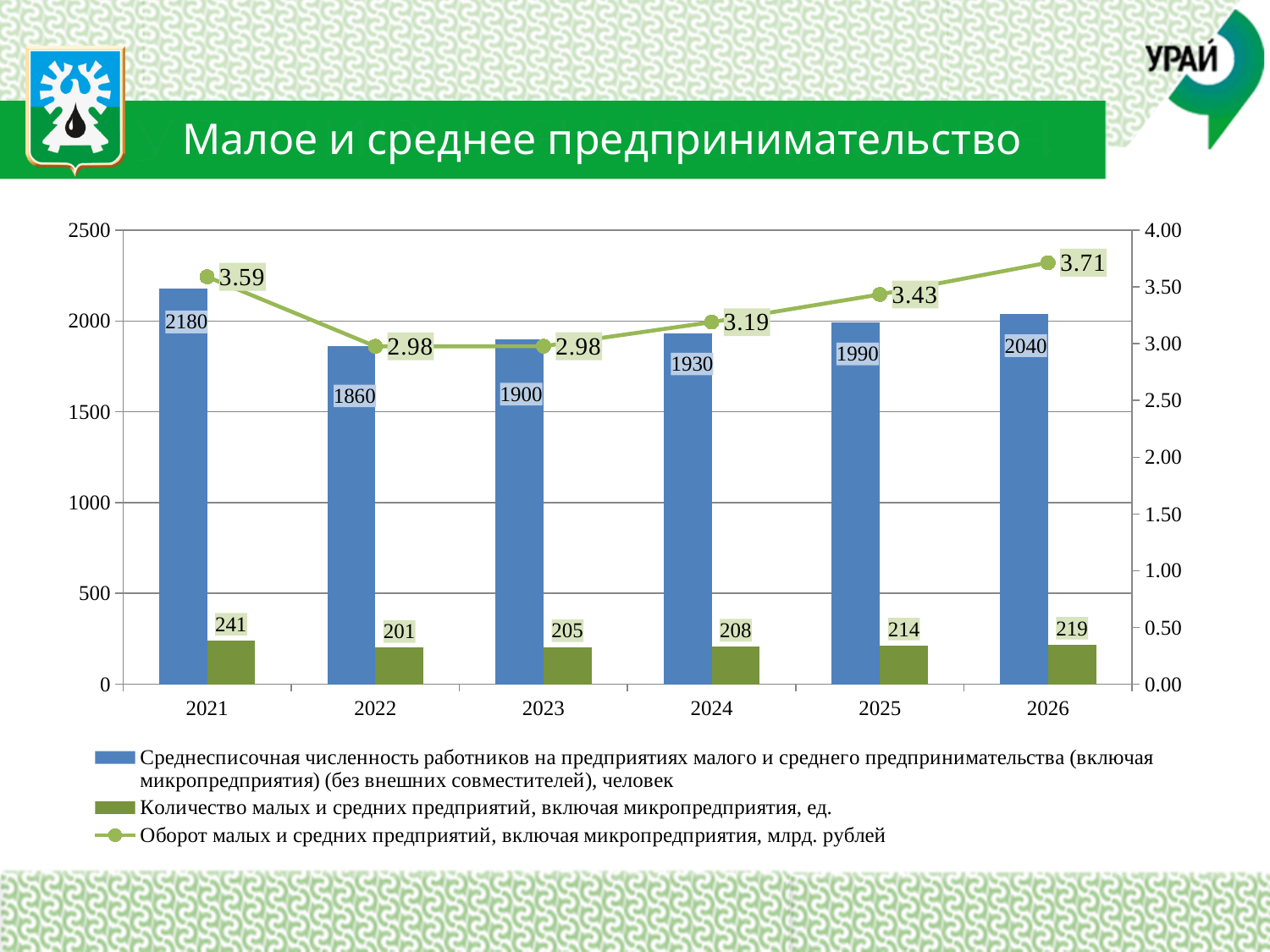
In which year is the number of small and medium enterprises (green bars) lowest? 2022 Which year has a larger number of small and medium enterprises (green bars): 2023 or 2026? 2026 In which year is the turnover of small and medium enterprises (line) highest? 2026 How many series does the legend of the chart list? 3 How many years are shown on the x axis of the chart? 6 What is the average headcount of employees at small and medium enterprises (blue bars) in 2021? 2180 Is the average headcount (blue bars) in 2025 greater or less than 1500? greater What is the title of the slide containing the chart? Малое и среднее предпринимательство What is the turnover of small and medium enterprises (line, billion rubles) in 2025? 3.43 Does the turnover of small and medium enterprises (line) rise or fall from 2023 to 2026? rise What is the difference between the average headcount (blue bars) in 2021 and in 2022? 320 What is the number of small and medium enterprises (green bars) in 2024? 208